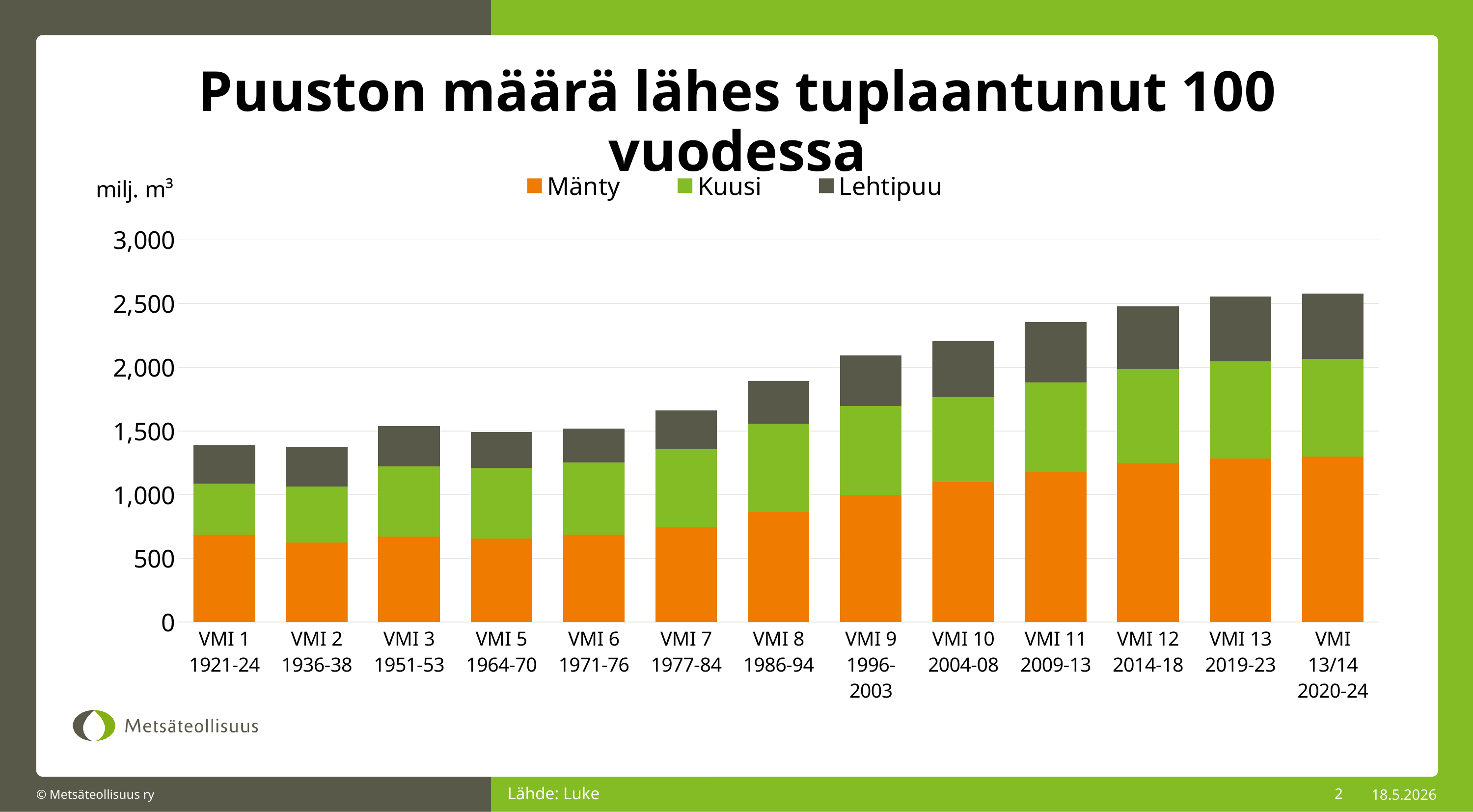
What unit is shown on the y axis? milj. m³ Is the Mänty value for VMI 13/14 2020-24 greater or less than 1,000? greater Is the total stacked value for VMI 1 1921-24 greater or less than 1,500? less Which series is shown in orange in the legend? Mänty Is the total stacked value for VMI 8 1986-94 greater or less than 2,000? less Do the total stacked values generally rise or fall from VMI 1 to VMI 13/14? rise What kind of chart is shown on the slide? Stacked bar chart How many inventory periods (bars) are shown on the x axis? 13 Which inventory period has the highest total stacked bar? VMI 13/14 2020-24 How many series does the legend list? 3 Which has the larger total stacked bar, VMI 10 2004-08 or VMI 3 1951-53? VMI 10 2004-08